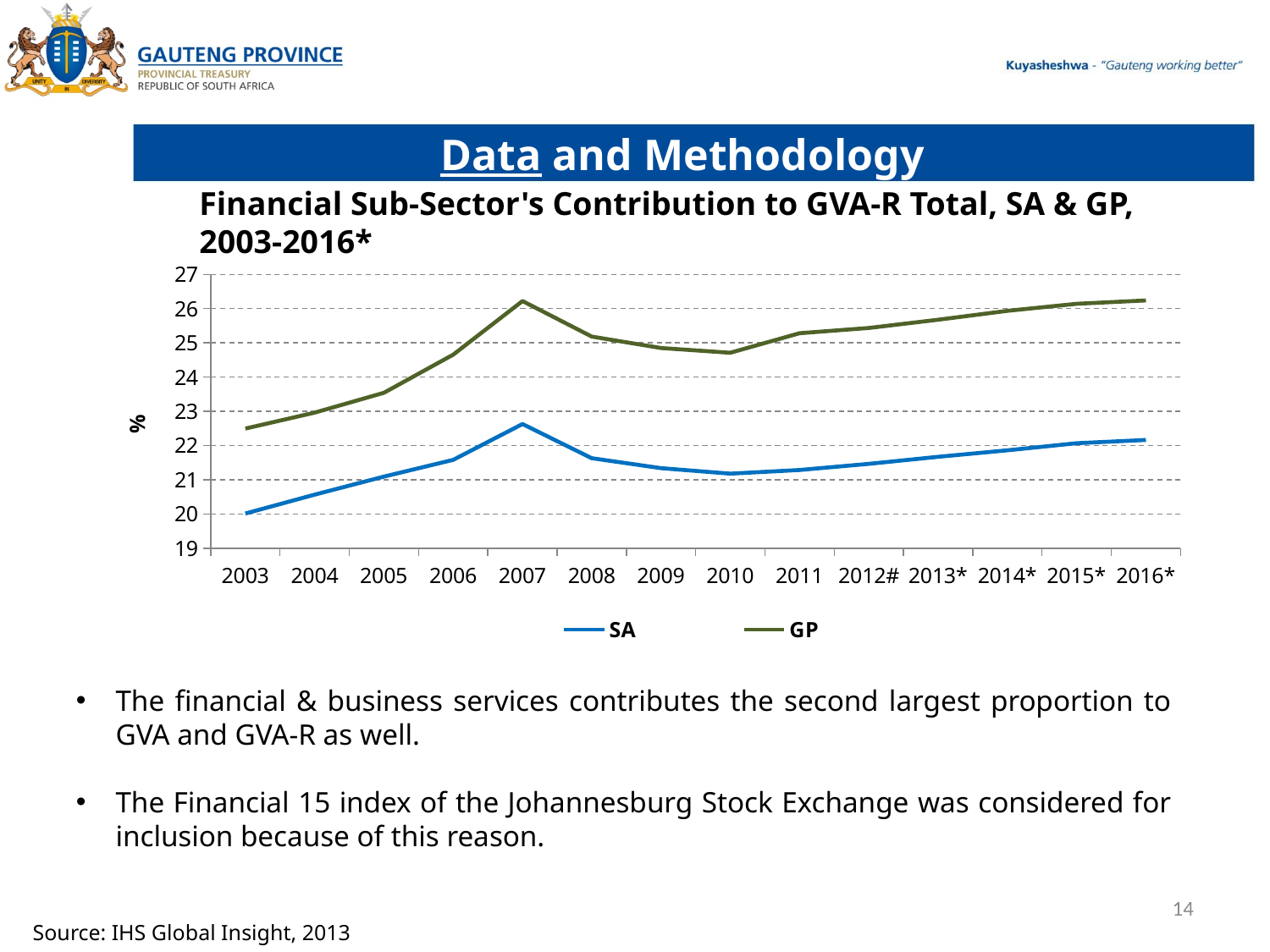
Which year has the highest value for the SA series? 2007 Is the value for GP in 2010 greater or less than 25? less What is the label on the y axis? % Is the value for SA in 2007 greater or less than 22? greater Which year has the lowest value for the GP series? 2003 In 2007, which series has the larger value, SA or GP? GP What kind of chart is shown on the slide? line chart Does the SA series rise or fall between 2007 and 2010? fall How many series does the legend list? 2 Is the value for SA in 2010 greater or less than 22? less How many years are shown along the x axis? 14 Which year has the lowest value for the SA series? 2003